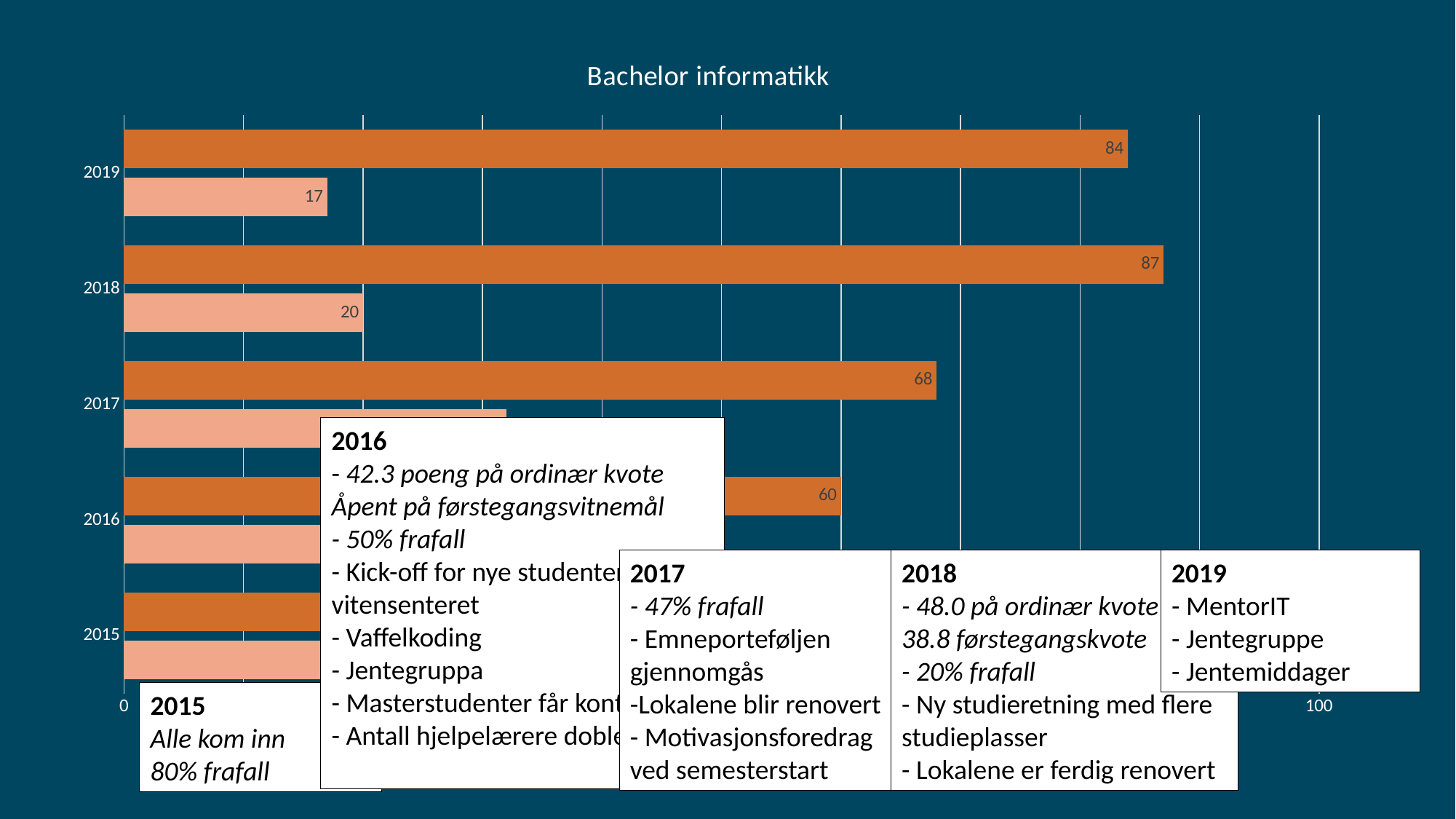
What is the value of the dark orange bar for 2016? 60 Is the value of the light orange bar for 2017 greater or less than 40? less Which year has the larger dark orange value, 2018 or 2019? 2018 What is the value of the light orange bar for 2019? 17 What is the value of the light orange bar for 2018? 20 What kind of chart is shown on the slide? bar chart What is the difference between the dark orange values for 2018 and 2019? 3 What is the value of the dark orange bar for 2019? 84 What is the value of the dark orange bar for 2017? 68 What is the title of the chart? Bachelor informatikk What is the difference between the dark orange and light orange values for 2019? 67 What is the value of the dark orange bar for 2018? 87